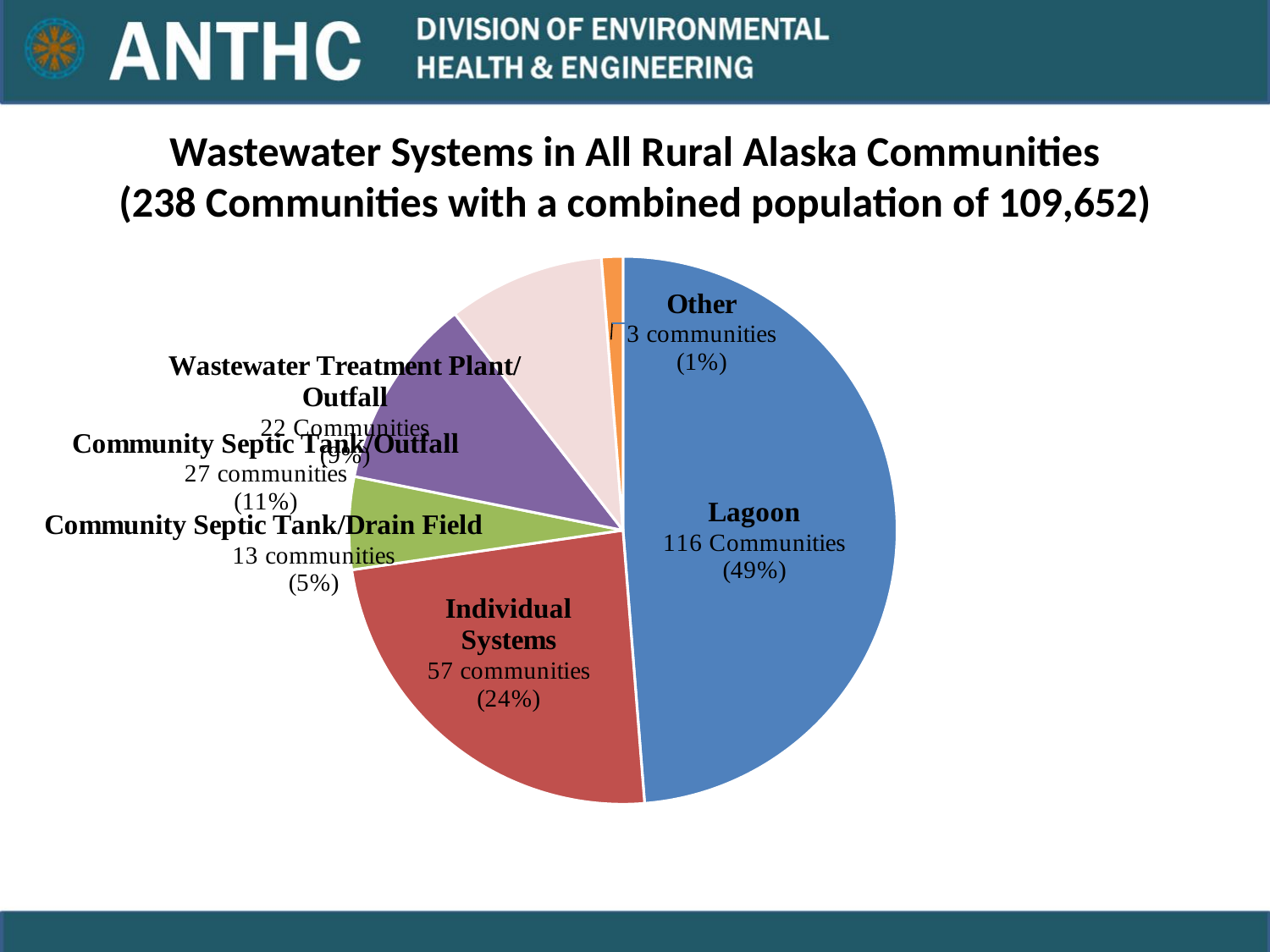
How many communities use a Wastewater Treatment Plant/Outfall? 22 How many communities use a Lagoon wastewater system? 116 What percentage of communities use Individual Systems? 24% How many categories does the pie chart show? 6 What percentage of communities use a Lagoon system? 49% Which wastewater system category has the largest share of the pie? Lagoon How many communities use a Community Septic Tank/Outfall? 27 How many more communities use a Lagoon than Individual Systems? 59 How many communities use a Community Septic Tank/Drain Field? 13 How many communities use Individual Systems? 57 What kind of chart is shown on the slide? pie chart Which wastewater system category has the smallest share of the pie? Other